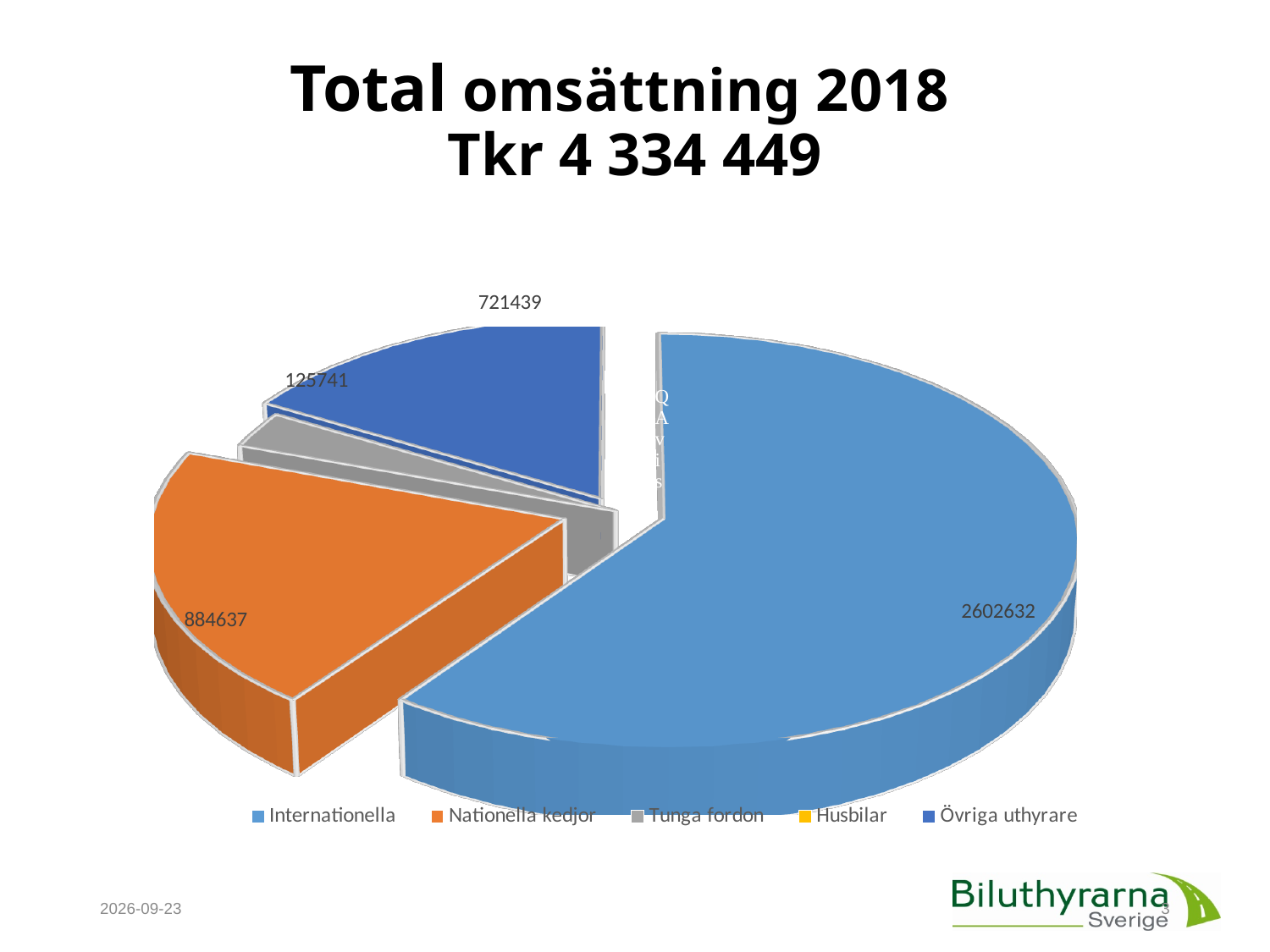
What is the title of the chart slide? Total omsättning 2018 Tkr 4 334 449 What is the difference between the values for Internationella and Nationella kedjor? 1717995 What is the value for Övriga uthyrare? 721439 What is the value for Tunga fordon? 125741 What is the value for Nationella kedjor? 884637 What is the value for Internationella? 2602632 Which is larger, Nationella kedjor or Övriga uthyrare? Nationella kedjor What kind of chart is shown on the slide? pie chart Which category has the largest slice of the pie? Internationella How many categories does the legend list? 5 What is the difference between the values for Övriga uthyrare and Tunga fordon? 595698